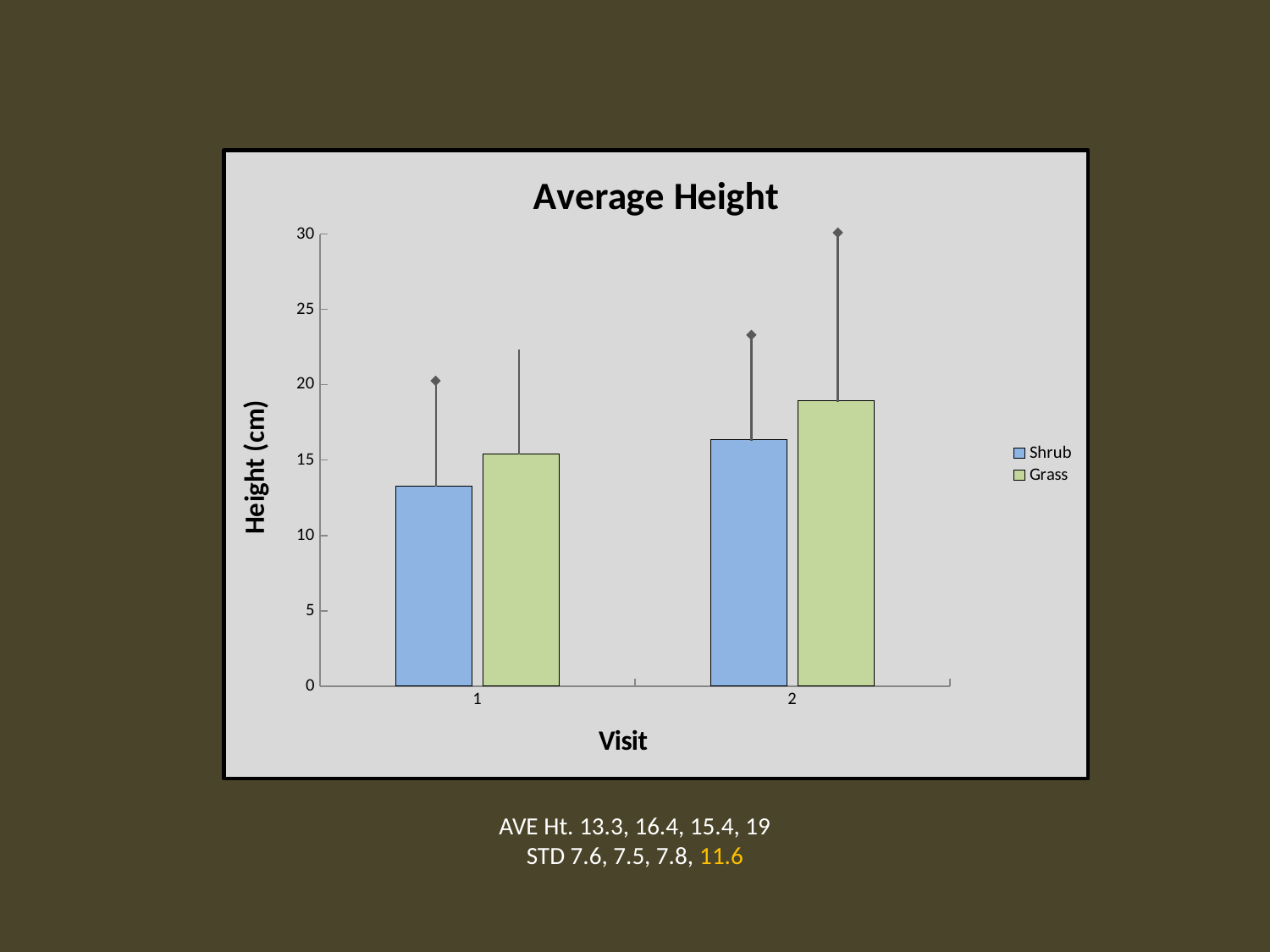
Which bar is the shortest in the chart? Shrub at Visit 1 Does the Shrub height rise or fall from Visit 1 to Visit 2? rise What is the title of the chart? Average Height How many series does the legend list? 2 Is the Grass value at Visit 2 greater or less than 20? less At Visit 2, which is taller, the Shrub bar or the Grass bar? Grass What kind of chart is shown on the slide? bar chart How many visit categories are shown on the x axis? 2 What is the label of the y axis? Height (cm) Is the Shrub value at Visit 1 greater or less than 15? less Which bar is the tallest in the chart? Grass at Visit 2 At Visit 1, which is taller, the Shrub bar or the Grass bar? Grass